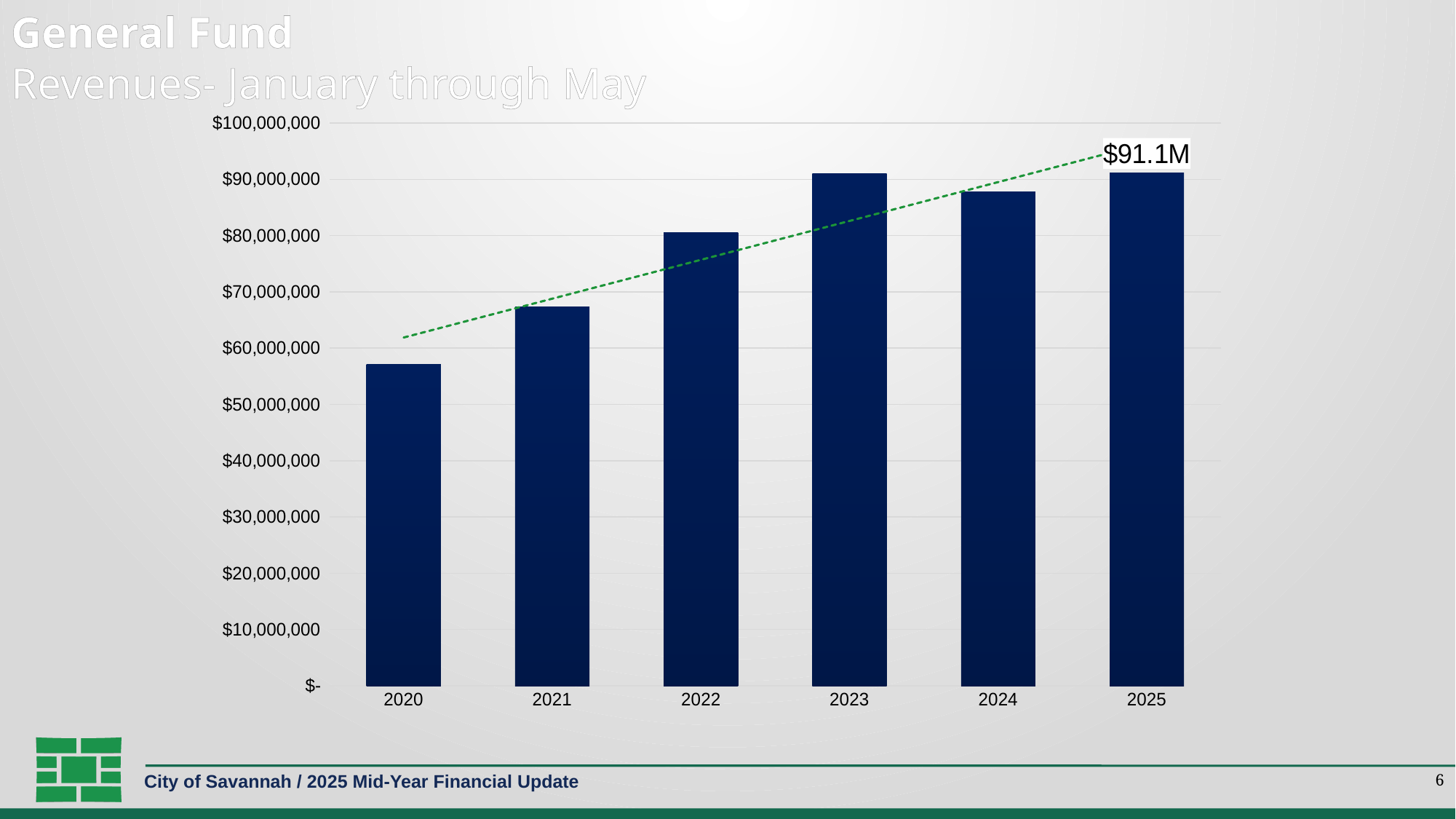
How many years are shown on the x axis? 6 From 2020 to 2023, do the values rise or fall? rise Is the value for 2020 greater or less than $60,000,000? less Is the value for 2024 greater or less than $90,000,000? less Which is larger, the value for 2023 or the value for 2024? 2023 Which year has the lowest revenue bar? 2020 Is the value for 2021 greater or less than $70,000,000? less What is the value shown for 2025? $91.1M Which is larger, the value for 2021 or the value for 2022? 2022 What is the title of the chart on the slide? General Fund Revenues- January through May What kind of chart is shown on the slide? Bar chart